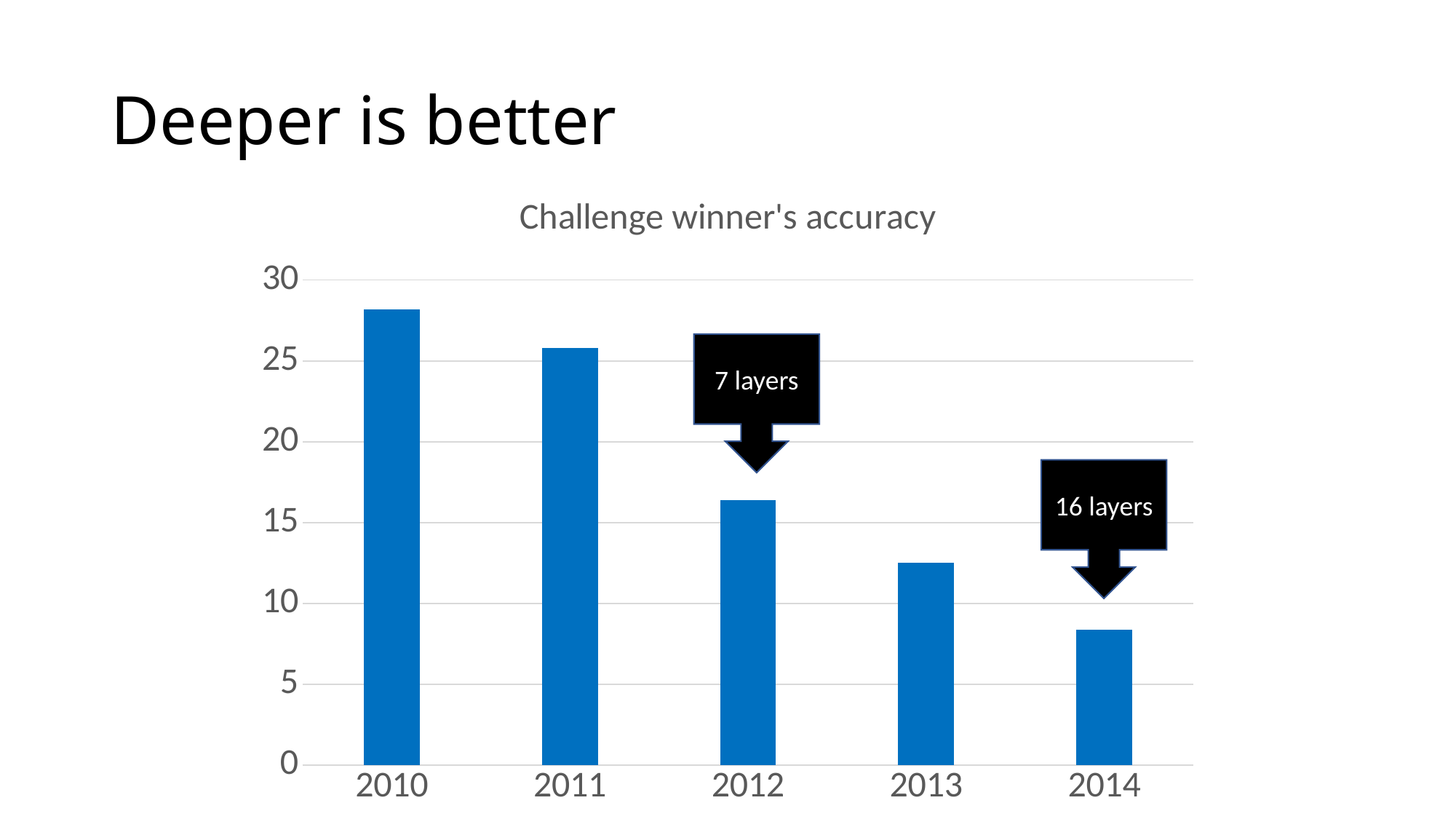
What is the title of the chart? Challenge winner's accuracy Is the value for 2010 greater or less than 25? greater Which is larger, the value for 2011 or the value for 2013? 2011 What kind of chart is shown on the slide? bar chart How many years are shown on the x axis of the chart? 5 What does the callout pointing at the 2014 bar say? 16 layers Is the value for 2013 greater or less than 10? greater Is the value for 2014 greater or less than 10? less Which year has the highest bar in the chart? 2010 Do the values rise or fall from 2010 to 2014? fall Which year has the lowest bar in the chart? 2014